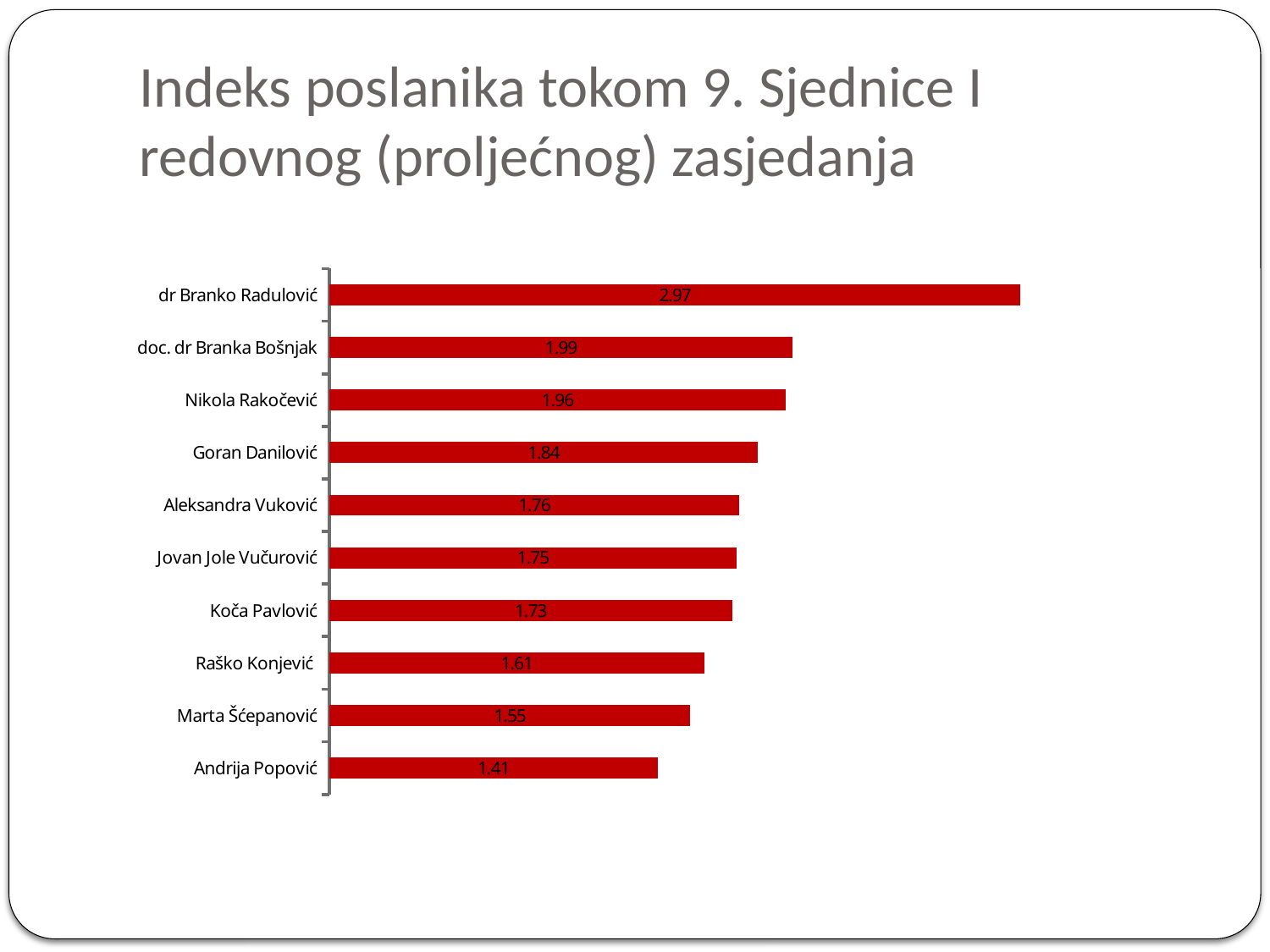
What is the title of the slide? Indeks poslanika tokom 9. Sjednice I redovnog (proljećnog) zasjedanja Which is larger, the value for Nikola Rakočević or the value for Koča Pavlović? Nikola Rakočević What is the difference between the values for dr Branko Radulović and doc. dr Branka Bošnjak? 0.98 What kind of chart is shown on the slide? bar chart Which category has the lowest value? Andrija Popović What is the value for Marta Šćepanović? 1.55 How many categories are shown in the chart? 10 What is the value for Goran Danilović? 1.84 What colour are the bars in the chart? red Which category has the highest value? dr Branko Radulović What is the value for dr Branko Radulović? 2.97 What is the difference between the values for Raško Konjević and Andrija Popović? 0.2